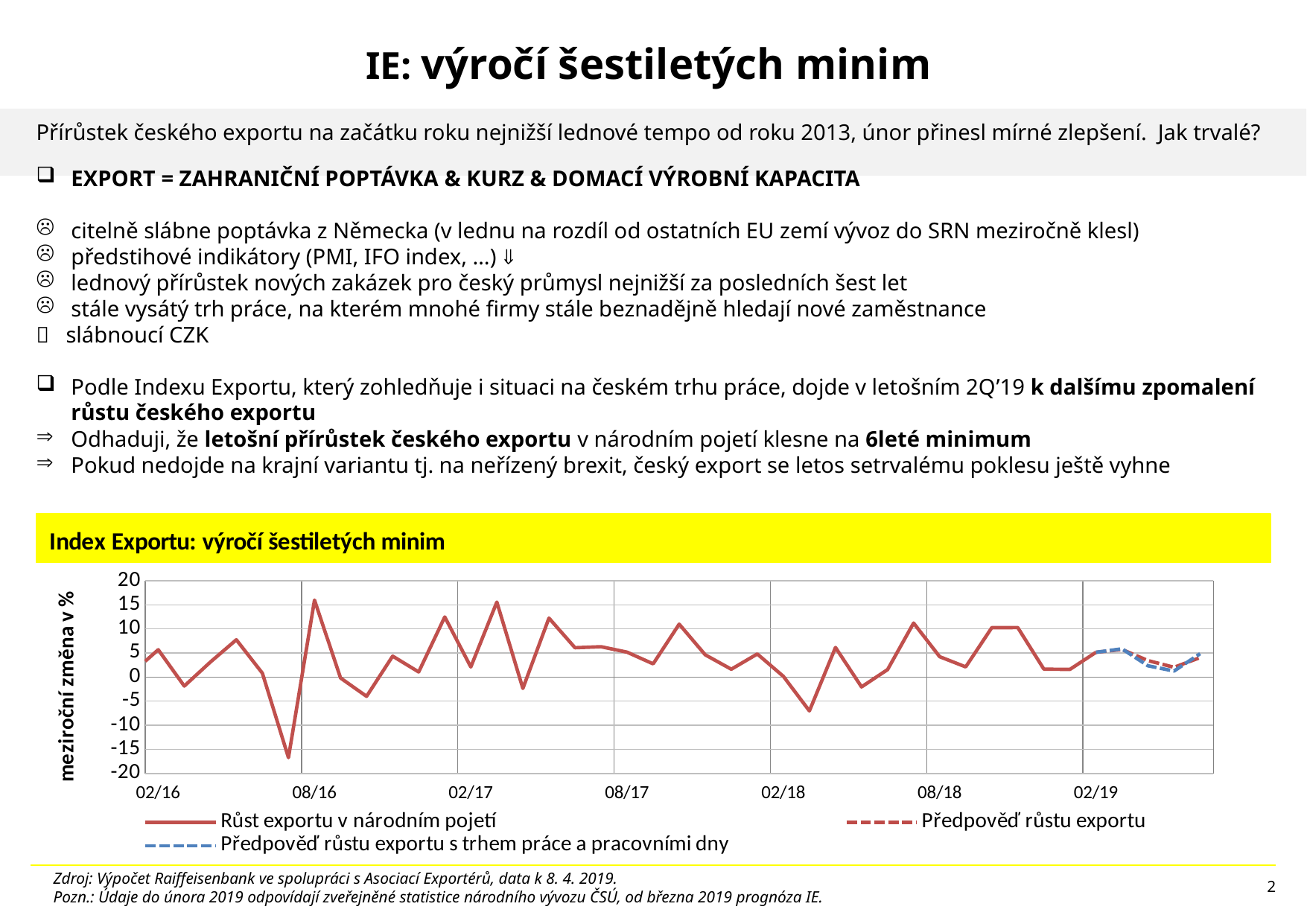
Is the value of 'Růst exportu v národním pojetí' at 08/16 greater or less than 10? greater What kind of chart is shown on the slide? line chart Is the value of 'Růst exportu v národním pojetí' at 02/16 greater or less than 0? greater What is the title of the chart? Index Exportu: výročí šestiletých minim Is the highest value of the series 'Růst exportu v národním pojetí' greater or less than 10? greater How many date labels are shown on the horizontal axis of the chart? 7 How many series does the chart legend list? 3 What is the label of the vertical axis of the chart? meziroční změna v % What is the highest tick value shown on the vertical axis of the chart? 20